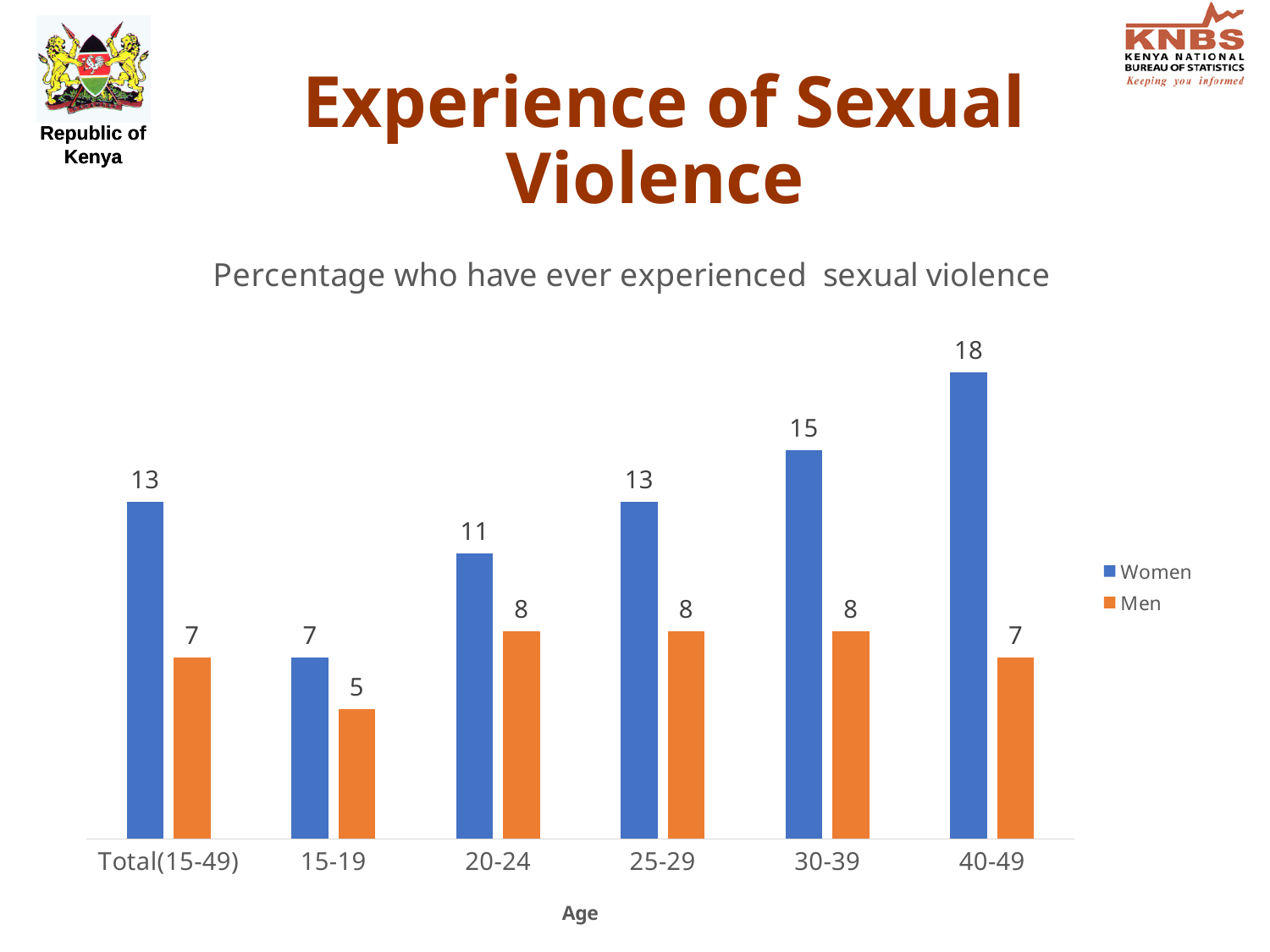
What is the title of the chart? Percentage who have ever experienced sexual violence Which age group has the highest value for Women? 40-49 Do the Women values rise or fall from the 15-19 age group to the 40-49 age group? Rise What is the value for Men in the 15-19 age group? 5 How many age categories are shown on the x axis? 6 What kind of chart is shown on the slide? Bar chart What is the value for Women in the 40-49 age group? 18 What is the value for Women in the Total(15-49) category? 13 Which age group has the lowest value for Men? 15-19 Which is larger, the Women value for 30-39 or the Women value for 25-29? Women value for 30-39 What is the difference between the Women and Men values in the 40-49 age group? 11 How many series does the legend list? 2